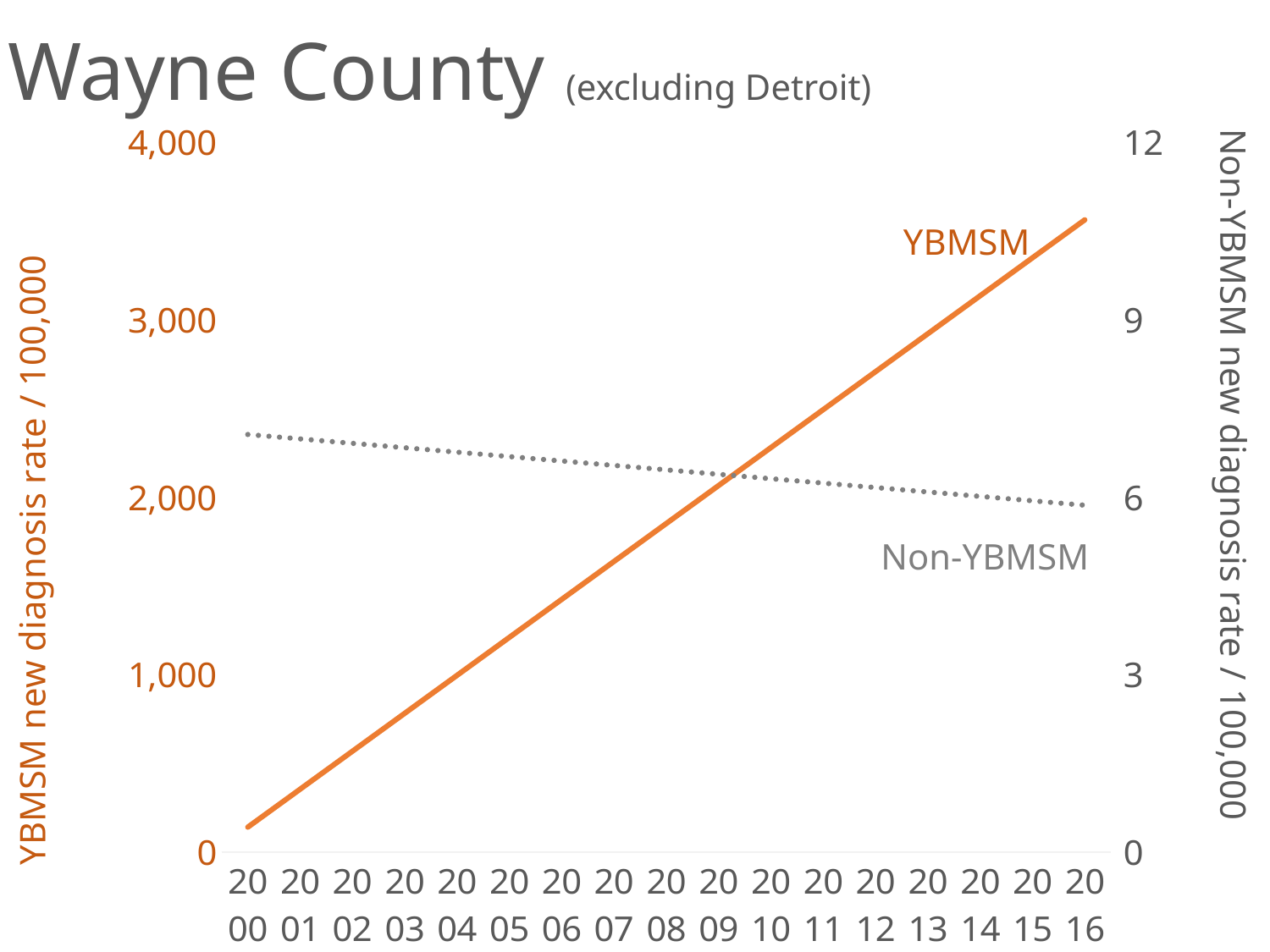
Does the Non-YBMSM new diagnosis rate rise or fall from 2000 to 2016? fall Is the YBMSM new diagnosis rate in 2000 greater or less than 1,000? less In which year is the Non-YBMSM new diagnosis rate highest? 2000 What is the title of the chart? Wayne County (excluding Detroit) In which year is the YBMSM new diagnosis rate highest? 2016 In which year is the YBMSM new diagnosis rate lowest? 2000 How many years are shown along the x axis? 17 How many series are plotted on the chart? 2 Does the YBMSM new diagnosis rate rise or fall from 2000 to 2016? rise Is the Non-YBMSM new diagnosis rate in 2000 greater or less than 6? greater What kind of chart is shown on the slide? line chart Is the YBMSM new diagnosis rate in 2016 greater or less than 3,000? greater